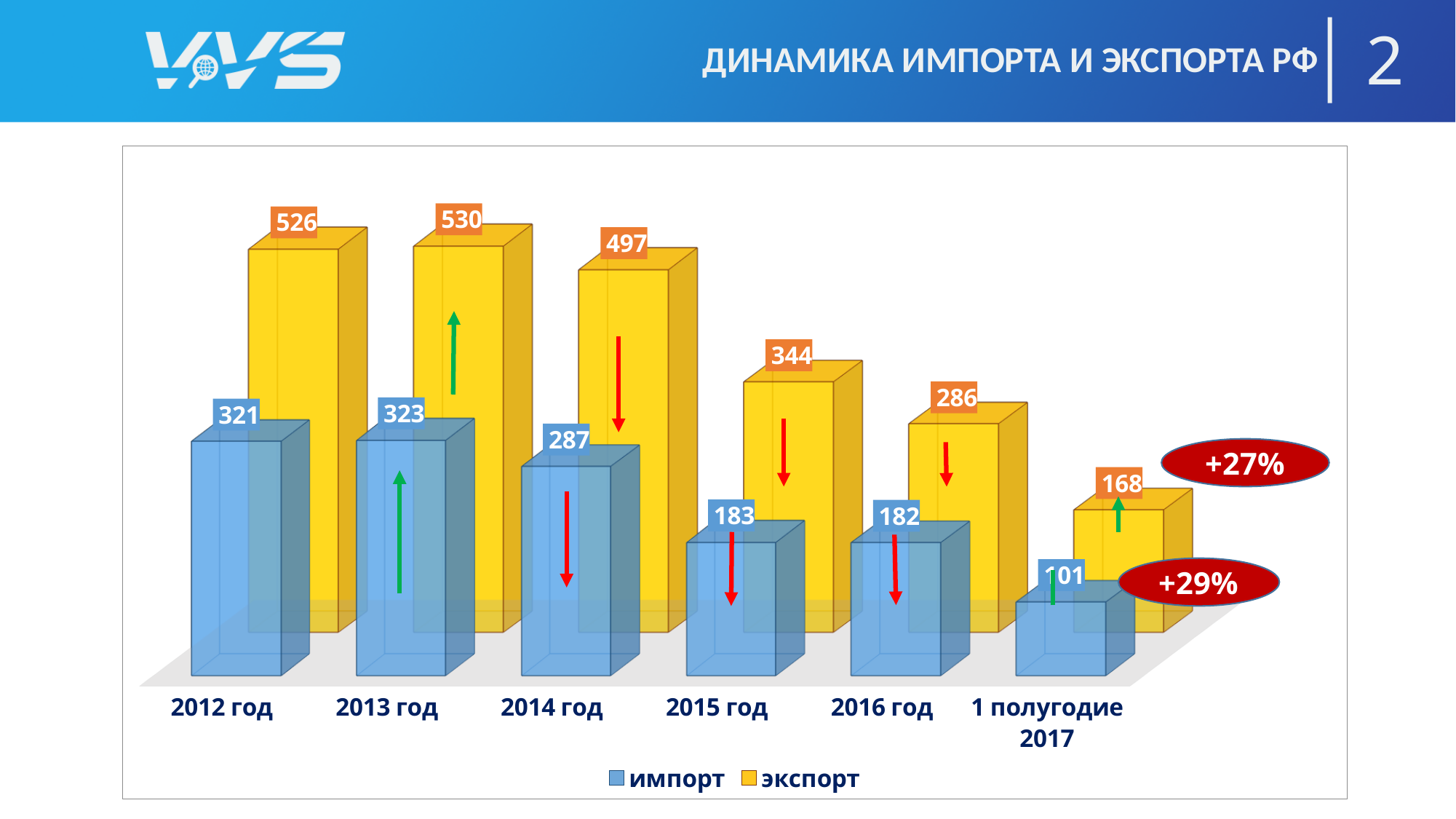
How many series does the legend list? 2 What is the export (экспорт) value for 2013 год? 530 What is the title of the slide? ДИНАМИКА ИМПОРТА И ЭКСПОРТА РФ Which category has the lowest import (импорт) value? 1 полугодие 2017 What kind of chart is shown on the slide? bar chart What is the difference between the export and import values for 2014 год? 210 Do the export (экспорт) values rise or fall from 2013 год to 2016 год? fall What is the import (импорт) value for 2015 год? 183 Which year has the highest export (экспорт) value? 2013 год What is the export (экспорт) value for 1 полугодие 2017? 168 Which is larger: the import value for 2012 год or the import value for 2014 год? 2012 год How many categories are shown on the x axis? 6